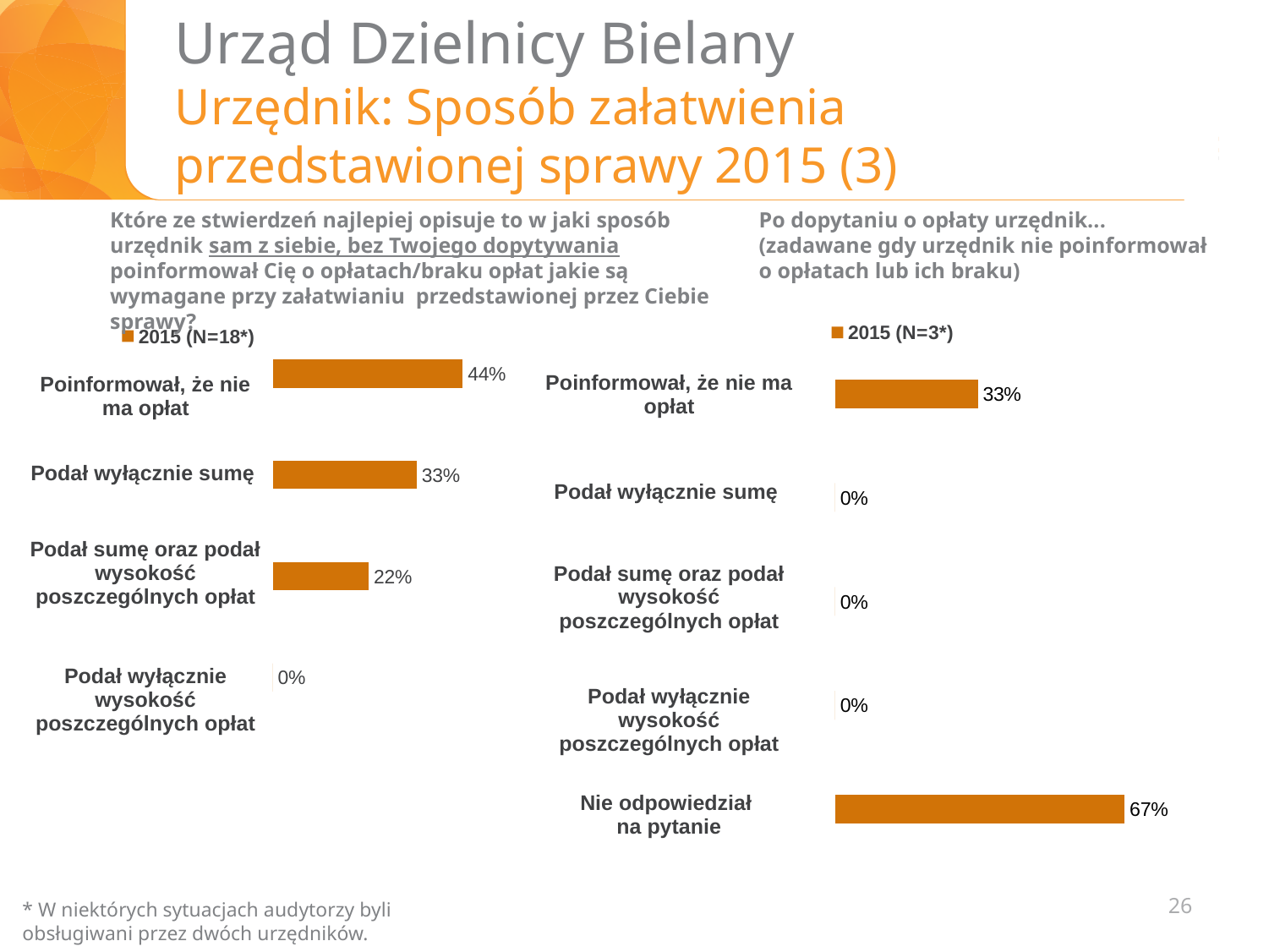
In the left chart (2015, N=18*), what is the value for "Poinformował, że nie ma opłat"? 44% How many categories are shown in the right chart (2015, N=3*)? 5 In the right chart (2015, N=3*), what is the value for "Nie odpowiedział na pytanie"? 67% In the left chart (2015, N=18*), which category has the highest value? Poinformował, że nie ma opłat In the left chart (2015, N=18*), what is the value for "Podał sumę oraz podał wysokość poszczególnych opłat"? 22% In the right chart (2015, N=3*), what is the value for "Poinformował, że nie ma opłat"? 33% In the right chart (2015, N=3*), which category has the highest value? Nie odpowiedział na pytanie What type of chart is the left chart (2015, N=18*)? Bar chart In the right chart (2015, N=3*), what is the difference between "Nie odpowiedział na pytanie" and "Poinformował, że nie ma opłat"? 34% How many categories are shown in the left chart (2015, N=18*)? 4 In the left chart (2015, N=18*), what is the difference between "Poinformował, że nie ma opłat" and "Podał wyłącznie sumę"? 11% In the left chart (2015, N=18*), which category has the lowest value? Podał wyłącznie wysokość poszczególnych opłat